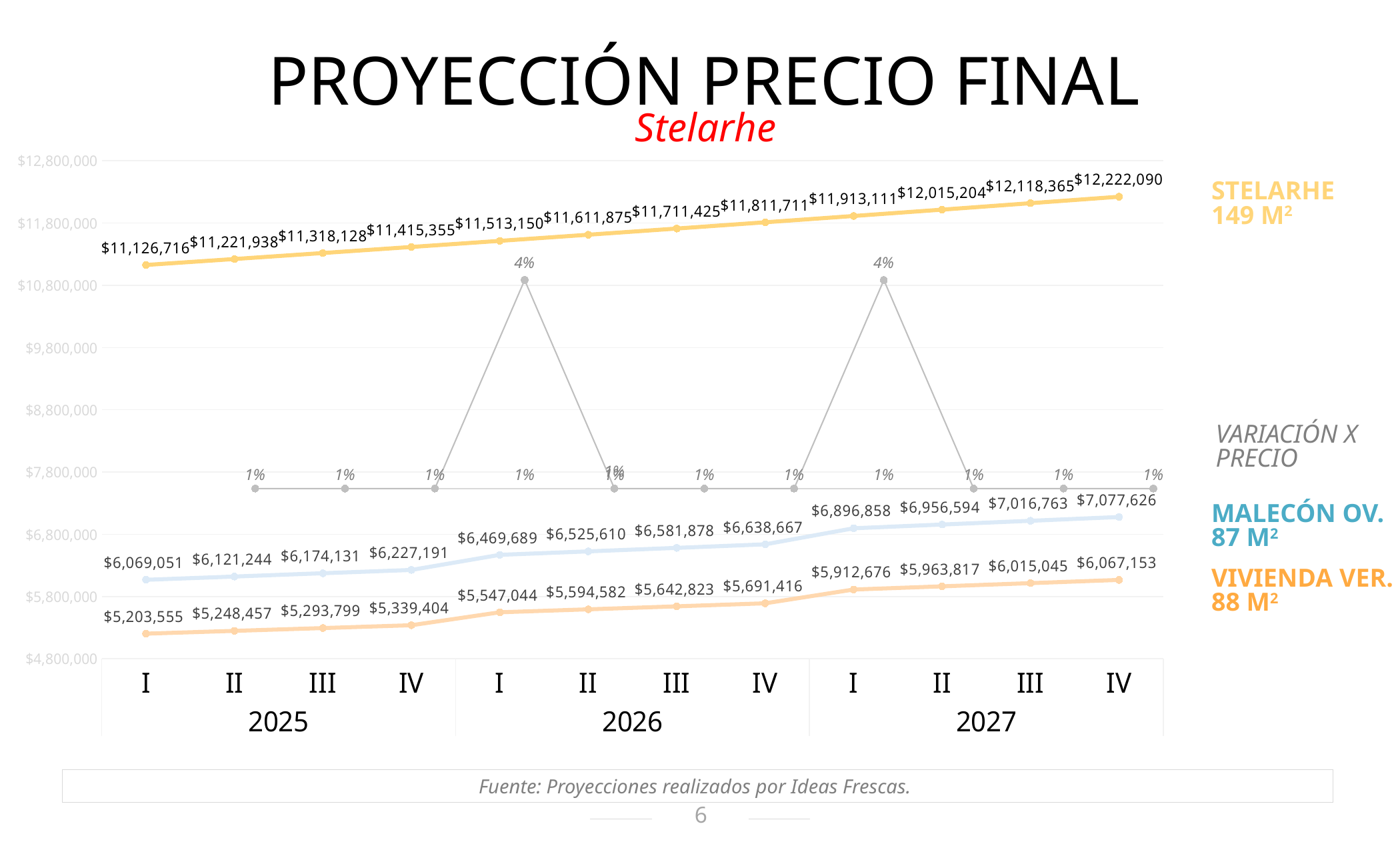
What is the difference between the Malecón Ov. and Vivienda Ver. prices in quarter IV of 2027? $1,010,473 By how much does the Stelarhe price in quarter IV of 2027 exceed its price in quarter I of 2025? $1,095,374 What is the projected price for Stelarhe in quarter I of 2025? $11,126,716 What is the projected price for Malecón Ov. in quarter I of 2026? $6,469,689 What kind of chart is shown on the slide? Line chart In quarter I of 2025, which is larger: the Malecón Ov. price or the Vivienda Ver. price? Malecón Ov. Which series has the highest projected prices throughout the chart? Stelarhe Do the Stelarhe prices rise or fall from 2025 to 2027? Rise What is the projected price for Stelarhe in quarter IV of 2027? $12,222,090 What is the projected price for Vivienda Ver. in quarter IV of 2027? $6,067,153 How many quarterly points are plotted along the x axis? 12 What is the Variación x precio value shown for quarter I of 2026? 4%